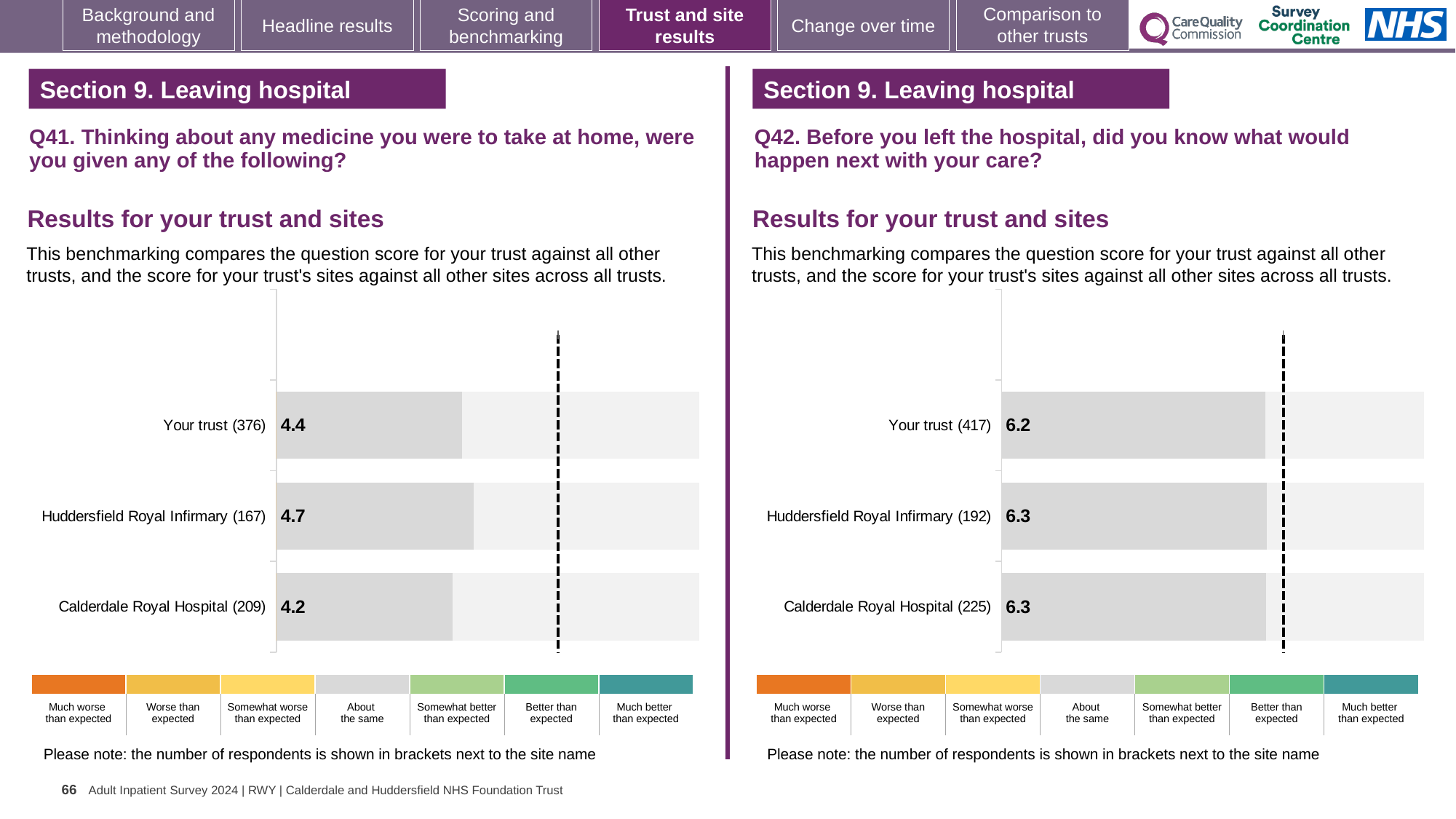
In the Q41 chart on the left, what is the score for Calderdale Royal Hospital? 4.2 In the Q41 chart on the left, what is the score for Your trust? 4.4 In the Q41 chart on the left, which site or trust has the highest score? Huddersfield Royal Infirmary In the Q41 chart on the left, which site or trust has the lowest score? Calderdale Royal Hospital In the Q42 chart on the right, how many respondents are shown for Huddersfield Royal Infirmary? 192 In the Q42 chart on the right, what is the score for Your trust? 6.2 In the Q41 chart on the left, what is the difference between the scores for Huddersfield Royal Infirmary and Calderdale Royal Hospital? 0.5 In the Q41 chart on the left, what is the score for Huddersfield Royal Infirmary? 4.7 In the Q41 chart on the left, how many respondents are shown for Your trust? 376 In the Q42 chart on the right, what is the score for Calderdale Royal Hospital? 6.3 What kind of chart is used in the Q41 chart on the left? Bar chart In the Q42 chart on the right, how many bars are plotted? 3